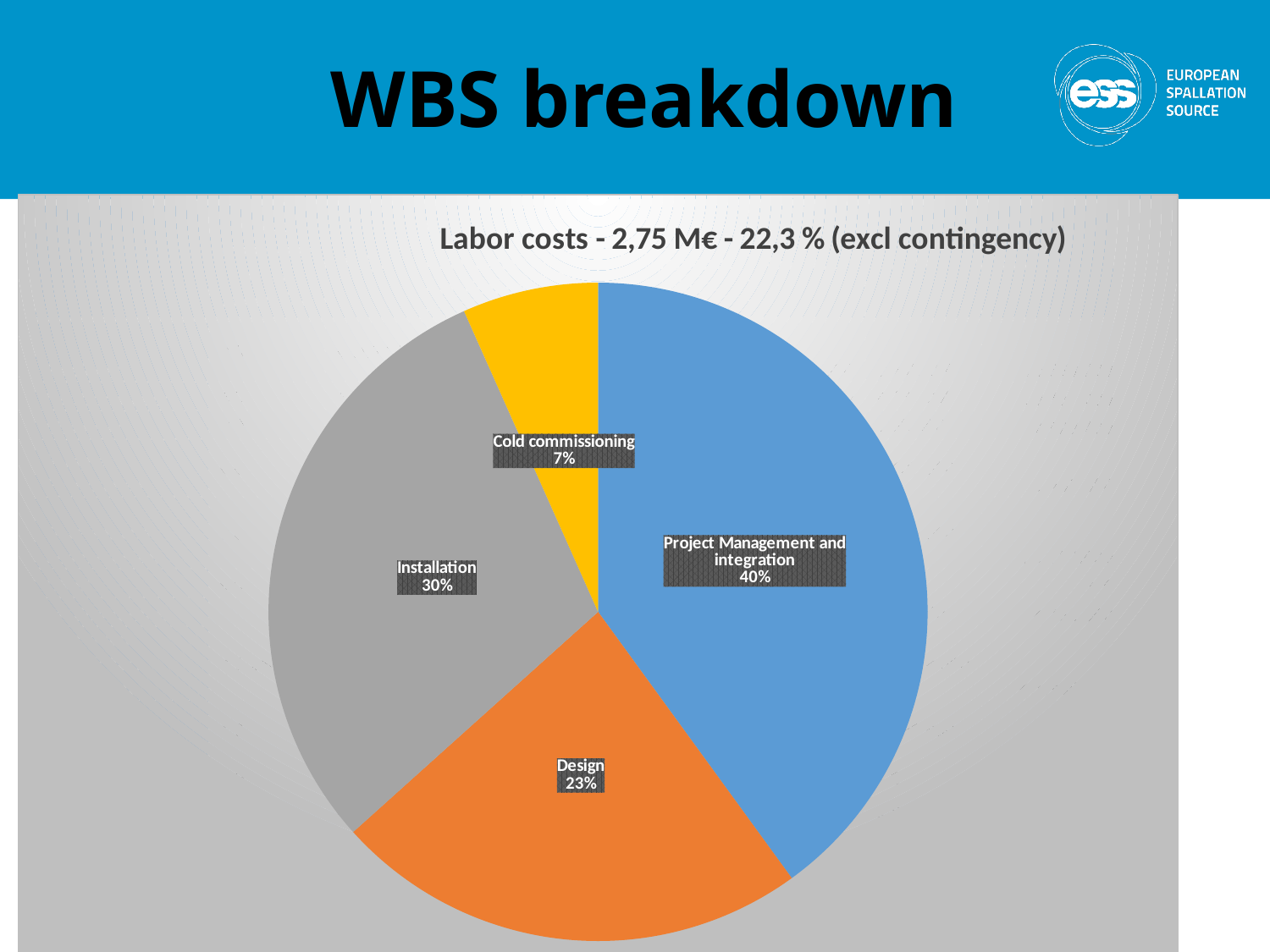
What share of the pie does Design take? 23% How many slices does the pie chart have? 4 What share of the pie does Installation take? 30% What is the title of the chart? Labor costs - 2,75 M€ - 22,3 % (excl contingency) What is the difference in percentage points between Installation and Design? 7 What share of the pie does Cold commissioning take? 7% Which is larger, Installation or Design? Installation What kind of chart is shown on the slide? pie chart What colour is the Cold commissioning slice? yellow Which slice is the smallest? Cold commissioning Which slice is the largest? Project Management and integration